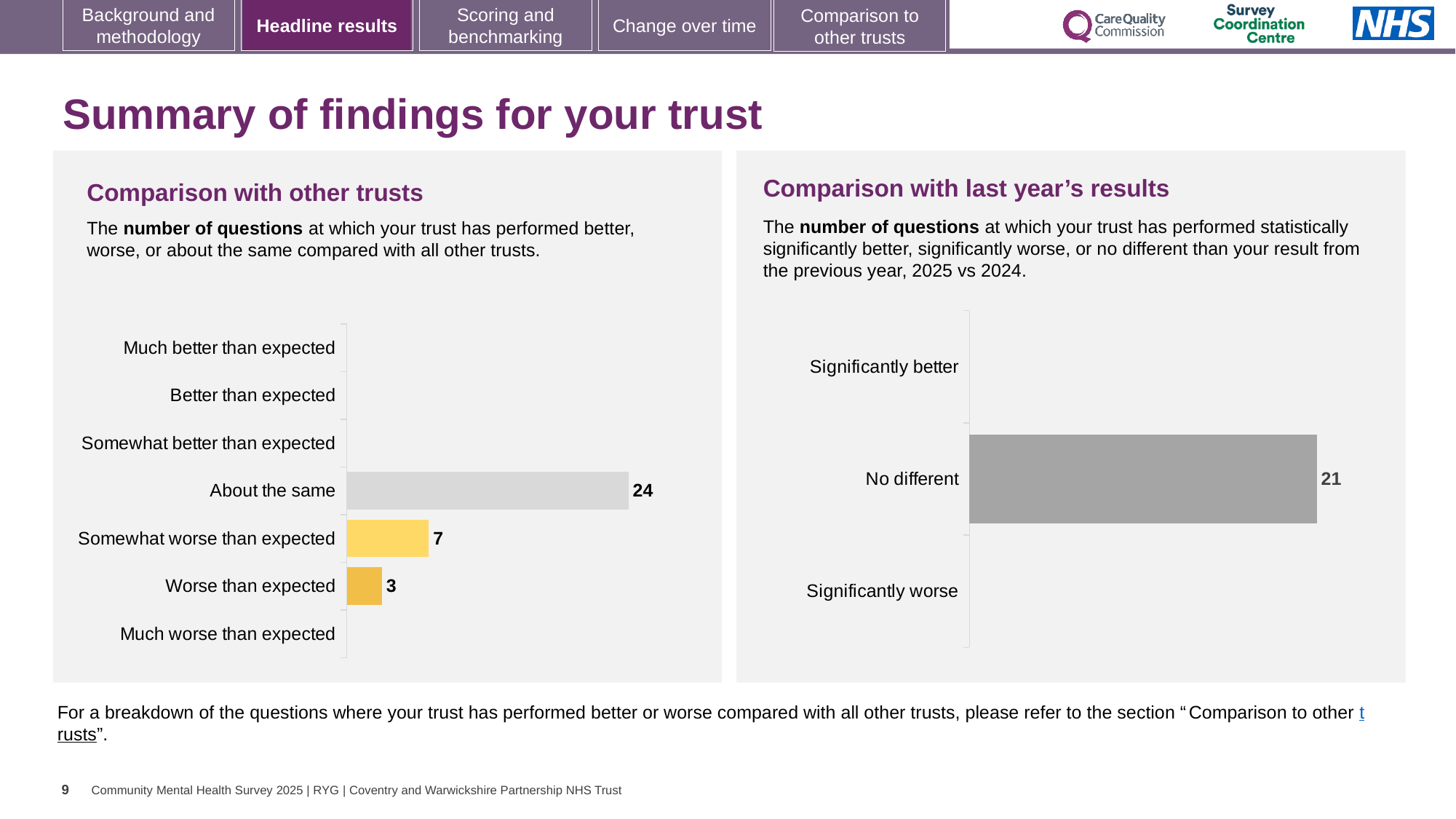
In the 'Comparison with other trusts' chart, what is the value for 'About the same'? 24 In the 'Comparison with last year's results' chart, what is the value for 'No different'? 21 What kind of chart is the 'Comparison with other trusts' chart? Bar chart How many categories are listed on the axis of the 'Comparison with other trusts' chart? 7 How many categories are listed on the axis of the 'Comparison with last year's results' chart? 3 In the 'Comparison with other trusts' chart, what is the value for 'Worse than expected'? 3 In the 'Comparison with other trusts' chart, which is larger: the value for 'Somewhat worse than expected' or 'Worse than expected'? Somewhat worse than expected In the 'Comparison with other trusts' chart, which category has the highest value? About the same In the 'Comparison with other trusts' chart, what colour is the bar for 'About the same'? Light grey In the 'Comparison with last year's results' chart, which category has the highest value? No different In the 'Comparison with other trusts' chart, what is the value for 'Somewhat worse than expected'? 7 In the 'Comparison with other trusts' chart, what is the difference between the values for 'About the same' and 'Somewhat worse than expected'? 17